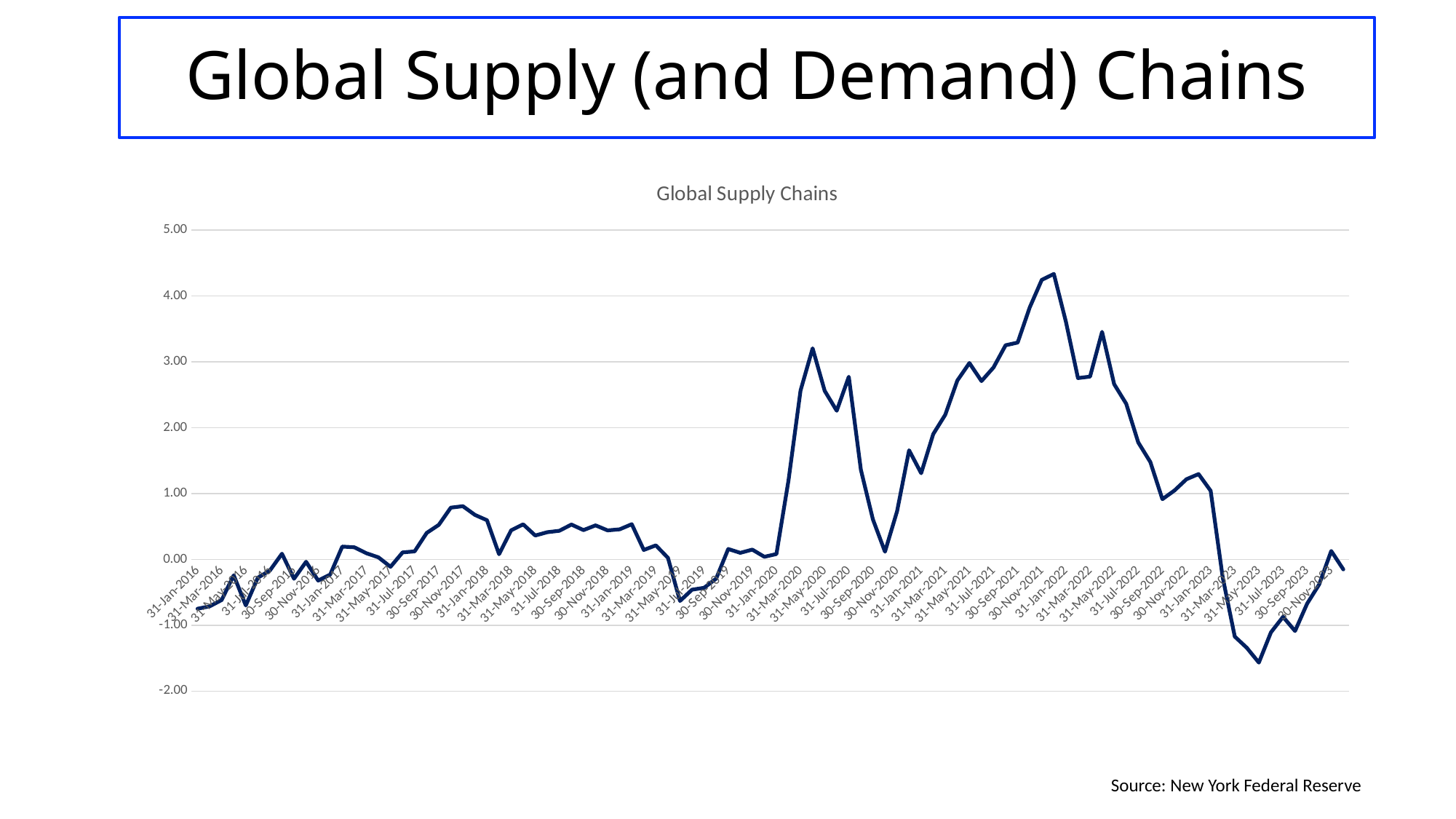
Is the value for 31-Jan-2020 greater or less than 1.00? less Do the values rise or fall between 31-Jan-2022 and 31-May-2023? fall Is the value for 31-Jan-2016 greater or less than 0.00? less What is the title of the chart? Global Supply Chains Is the value for 31-May-2020 greater or less than 2.00? greater What source is cited for the chart? New York Federal Reserve How many data series are plotted on the chart? 1 Which is larger, the value for 31-Jan-2022 or the value for 31-Jan-2018? 31-Jan-2022 What kind of chart is shown on the slide? line chart